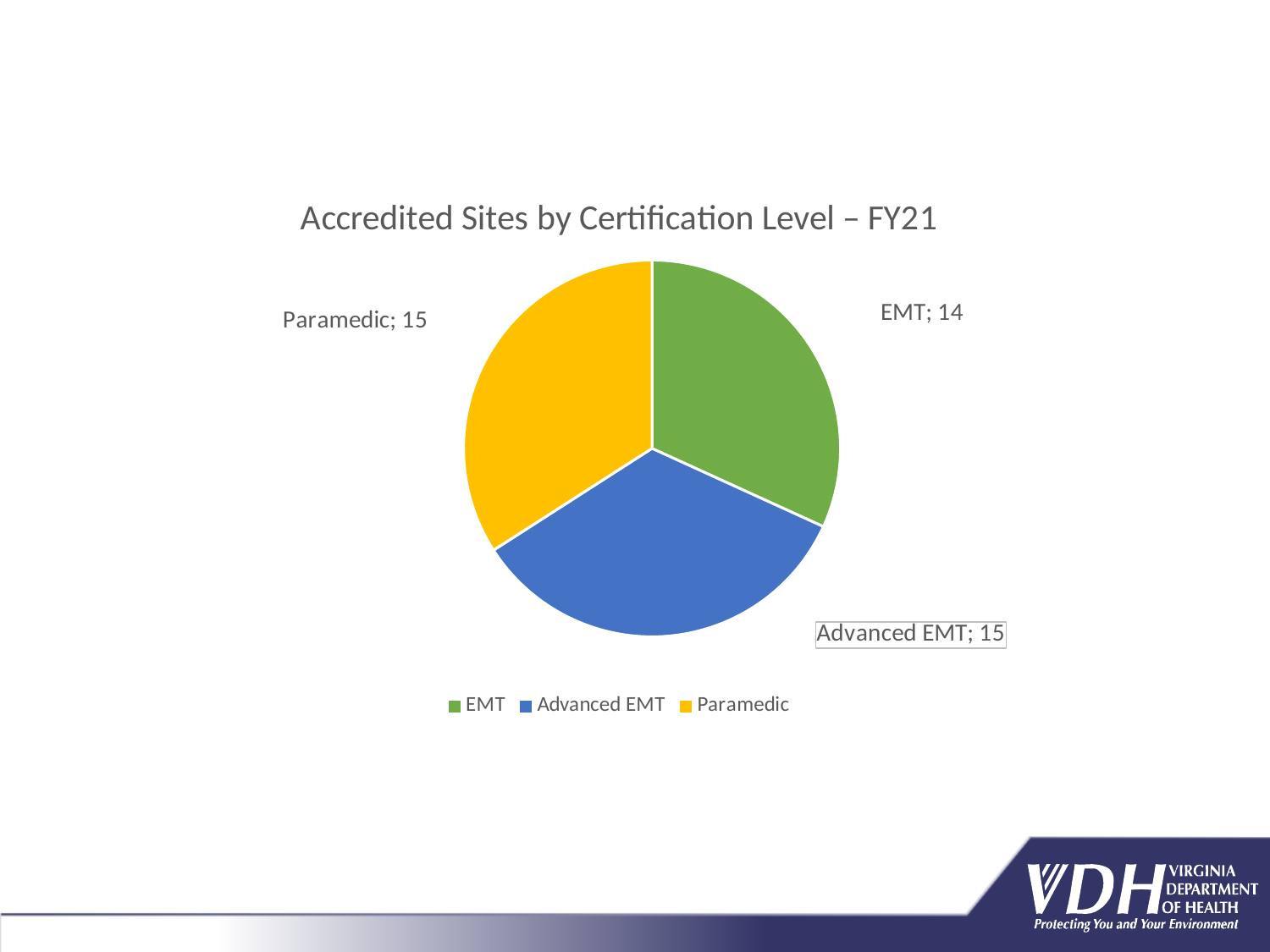
How many slices does the pie chart have? 3 How many accredited sites are at the EMT level? 14 Which certification level has the fewest accredited sites? EMT What is the difference between the number of Paramedic sites and the number of EMT sites? 1 How many entries does the legend list? 3 How many accredited sites are at the Paramedic level? 15 How many accredited sites are at the Advanced EMT level? 15 What is the total number of accredited sites across all three certification levels? 44 What type of chart is shown on the slide? Pie chart Which has more accredited sites, EMT or Advanced EMT? Advanced EMT What is the title of the chart? Accredited Sites by Certification Level – FY21 Which colour represents Paramedic in the pie chart? Yellow